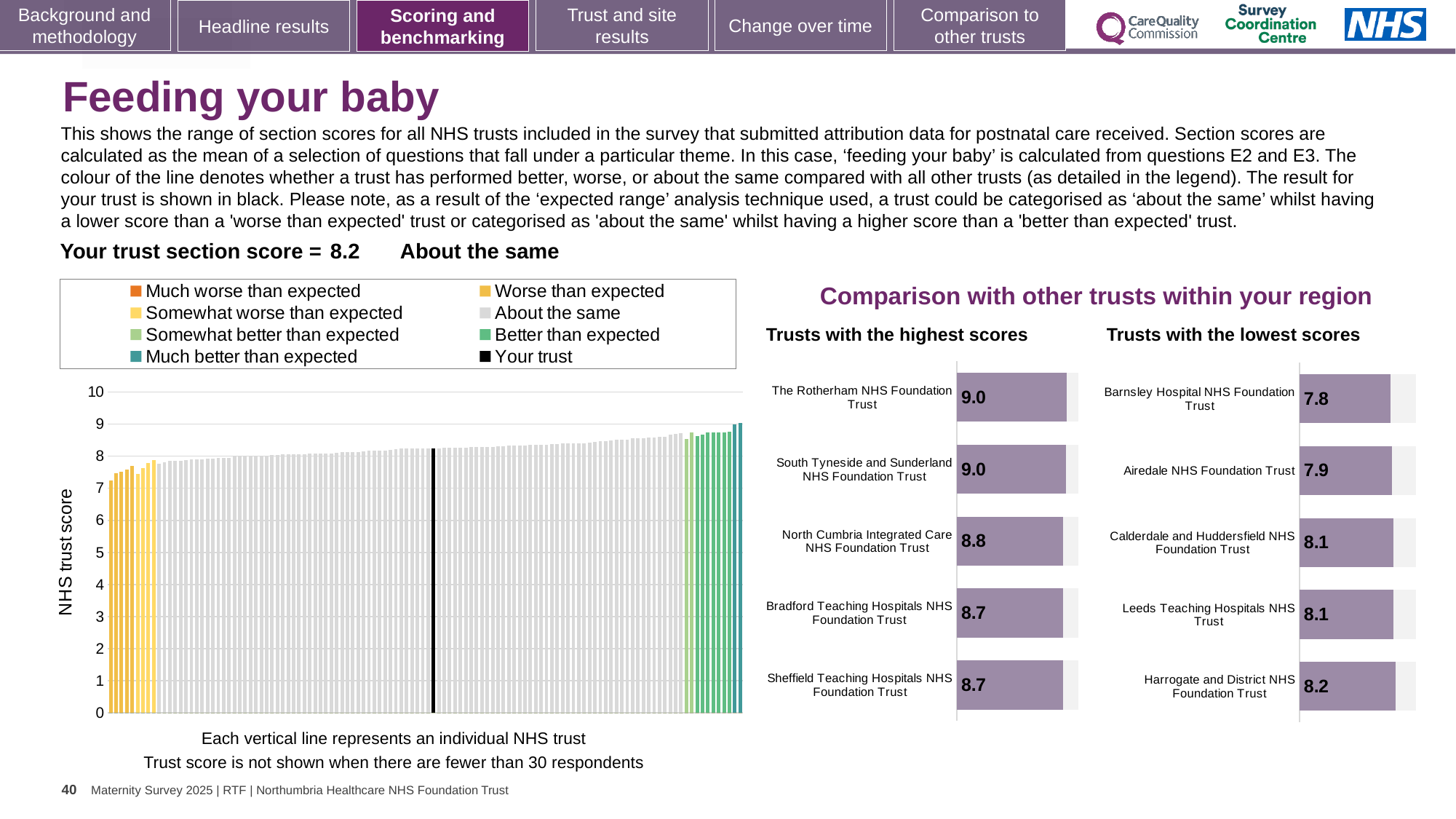
In the 'Trusts with the highest scores' chart, what is the difference between the scores of The Rotherham NHS Foundation Trust and Sheffield Teaching Hospitals NHS Foundation Trust? 0.3 In the left-hand chart, do the bars rise or fall from left to right? Rise What kind of chart is the large chart on the left showing all NHS trusts? Bar chart In the left-hand chart, is the value of the leftmost bar greater or less than 8? less In the 'Trusts with the highest scores' chart, what is the score for The Rotherham NHS Foundation Trust? 9.0 In the 'Trusts with the lowest scores' chart, which trust has the highest score? Harrogate and District NHS Foundation Trust What is the y-axis label of the left-hand chart? NHS trust score In the 'Trusts with the highest scores' chart, what is the score for North Cumbria Integrated Care NHS Foundation Trust? 8.8 How many trusts are shown in the 'Trusts with the lowest scores' chart? 5 In the 'Trusts with the lowest scores' chart, what is the difference between the scores of Harrogate and District NHS Foundation Trust and Barnsley Hospital NHS Foundation Trust? 0.4 How many entries does the legend of the left-hand chart list? 8 In the 'Trusts with the lowest scores' chart, which trust has the lowest score? Barnsley Hospital NHS Foundation Trust